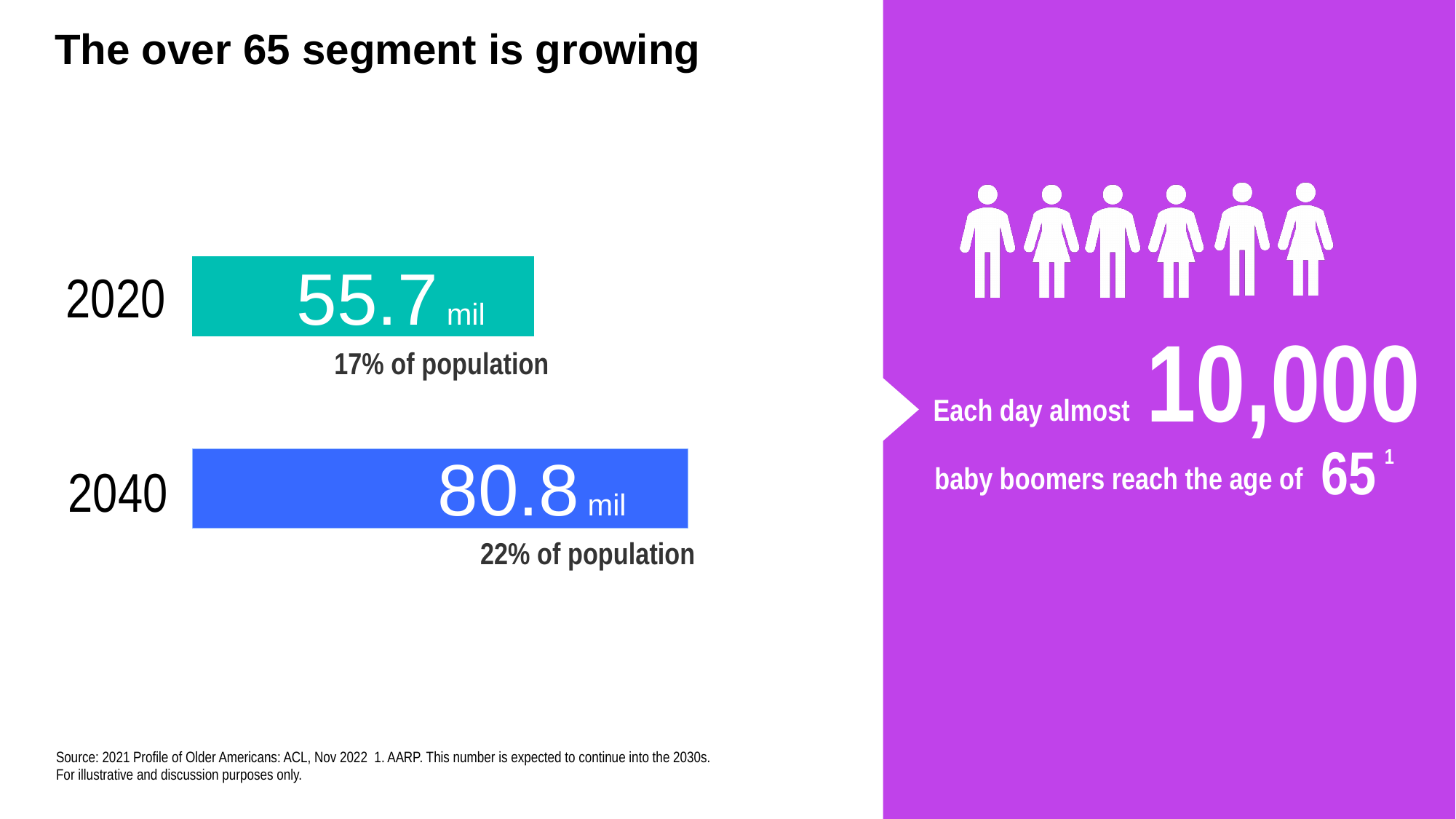
What is the difference in millions between the 2040 and 2020 values? 25.1 mil What is the title of the chart? The over 65 segment is growing How many bars are shown in the chart? 2 Is the value for 2040 larger or smaller than the value for 2020? larger What kind of chart is shown on the slide? bar chart What is the value shown for 2040? 80.8 mil What percentage of the population does the 2020 bar represent? 17% of population Which year has the smaller bar? 2020 What percentage of the population does the 2040 bar represent? 22% of population By how many percentage points does the population share rise from 2020 to 2040? 5 percentage points Which year has the larger bar? 2040 What is the value shown for 2020? 55.7 mil